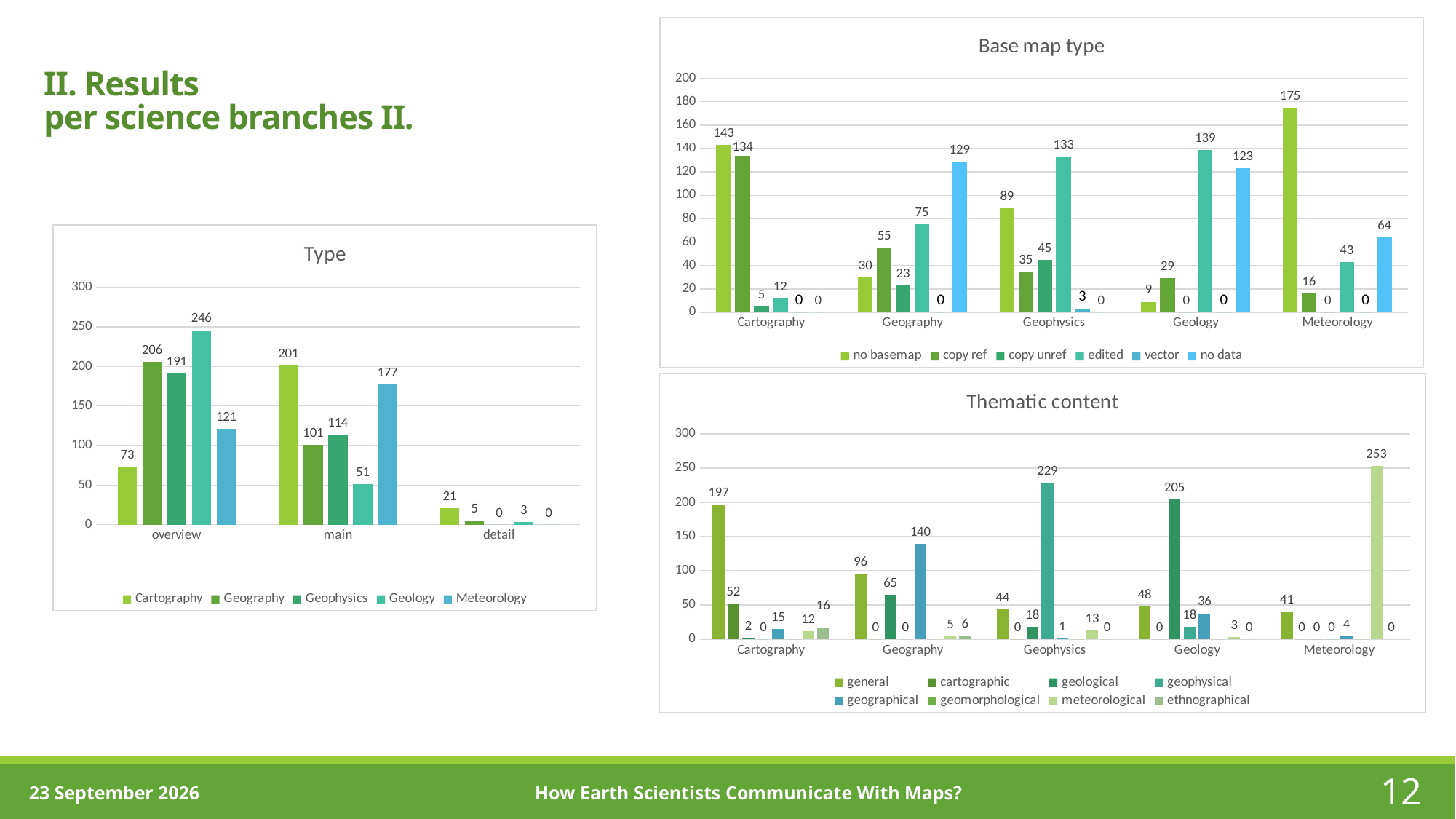
In the Type chart, how many series does the legend list? 5 In the Base map type chart, what is the value for no basemap in Meteorology? 175 In the Thematic content chart, which category has the highest value for general? Cartography In the Base map type chart, how many categories are shown on the x axis? 5 In the Base map type chart, what is the difference between edited and copy ref in Geology? 110 In the Type chart, what is the value for Geology in the overview category? 246 In the Thematic content chart, what is the value for general in Cartography? 197 What kind of chart is the Thematic content chart? bar chart In the Type chart, what is the difference between Geography and Cartography in the overview category? 133 In the Type chart, which series has the highest value in the main category? Cartography In the Base map type chart, which category has the highest value for no data? Geography In the Base map type chart, which is larger for Geophysics: no basemap or edited? edited